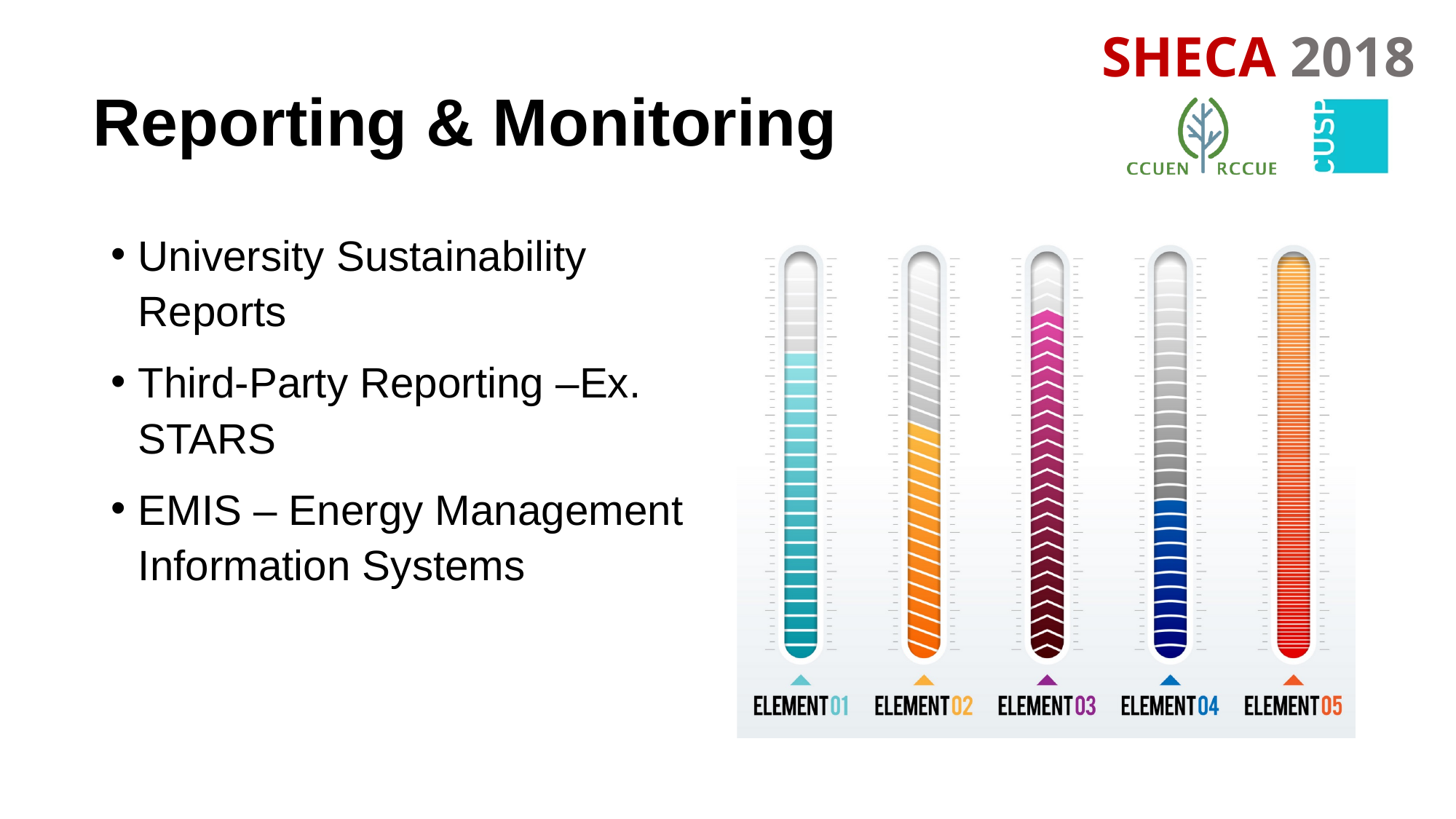
Which is filled higher, Element 01 or Element 02? Element 01 Which element has the lowest fill level in the chart? Element 04 Which is filled higher, Element 05 or Element 01? Element 05 What kind of chart is shown on the slide? Bar chart (thermometer-style vertical bars) How many elements (categories) are shown in the thermometer chart? 5 Which is filled higher, Element 02 or Element 03? Element 03 What colour is the fill for Element 04? Blue What colour is the fill for Element 03? Magenta/purple Which element has the highest fill level in the chart? Element 05